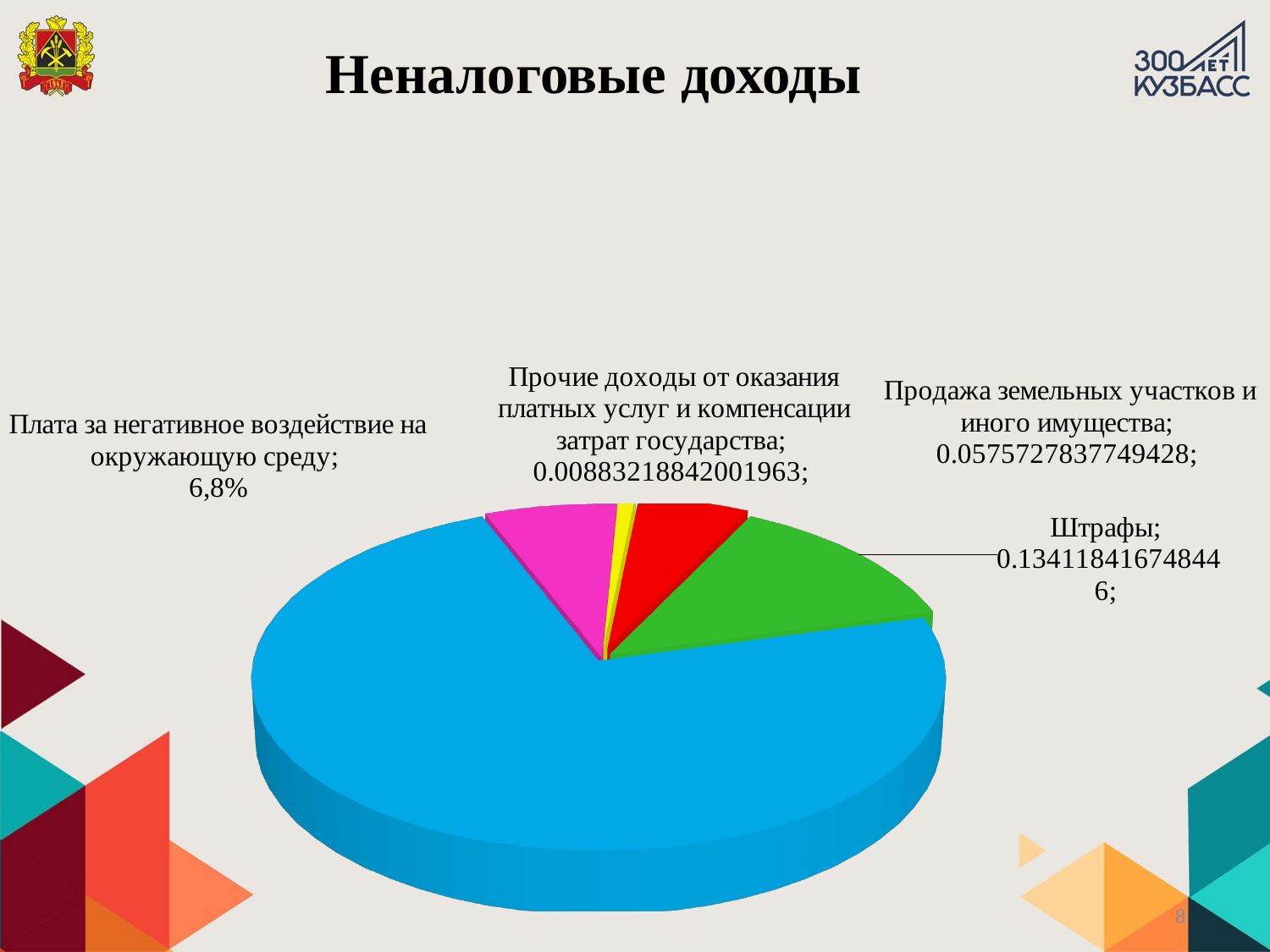
Which of the labelled categories has the smallest value? Прочие доходы от оказания платных услуг и компенсации затрат государства What colour is the slice for Штрафы? green What value is shown for Плата за негативное воздействие на окружающую среду? 6,8% Which is larger: Штрафы or Продажа земельных участков и иного имущества? Штрафы How many slices does the pie chart have? 5 Which of the labelled categories has the largest value? Штрафы What value is shown for Продажа земельных участков и иного имущества? 0.0575727837749428 What value is shown for Прочие доходы от оказания платных услуг и компенсации затрат государства? 0.00883218842001963 What value is shown for Штрафы? 0.134118416748446 Is the value for Штрафы greater or less than 0.1? greater What kind of chart is shown on the slide? pie chart What is the title of the chart? Неналоговые доходы